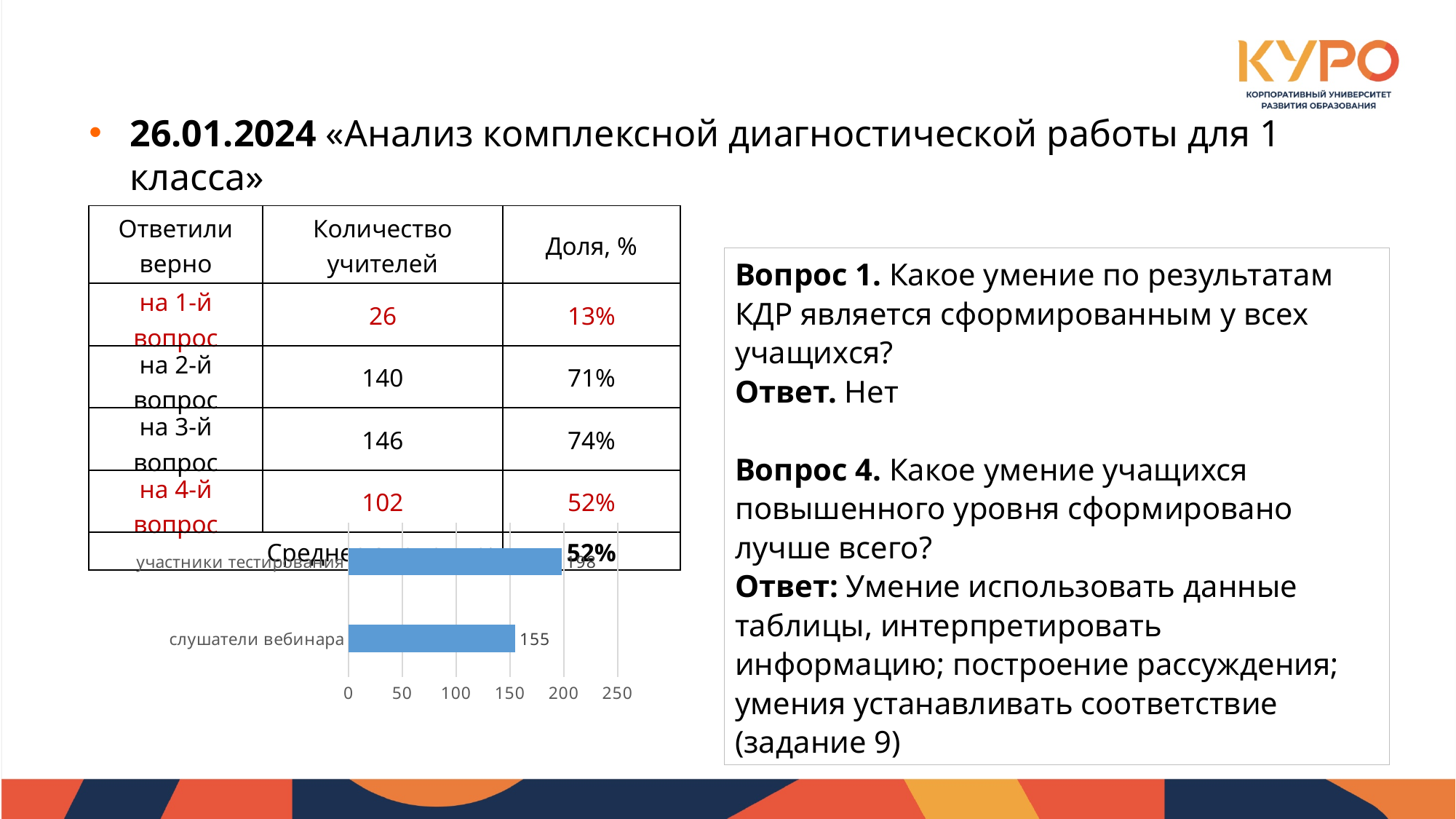
How many categories does the bar chart show? 2 Which category has the lowest value in the bar chart? слушатели вебинара Is the value for слушатели вебинара greater or less than 200? less Which is larger in the bar chart: участники тестирования or слушатели вебинара? участники тестирования What is the value for слушатели вебинара in the bar chart? 155 What is the maximum value shown on the x axis of the bar chart? 250 What is the value for участники тестирования in the bar chart? 198 Is the value for слушатели вебинара greater or less than 100? greater What is the difference between the values for участники тестирования and слушатели вебинара? 43 Is the value for участники тестирования greater or less than 150? greater What kind of chart is shown on the slide? bar chart Which category has the highest value in the bar chart? участники тестирования